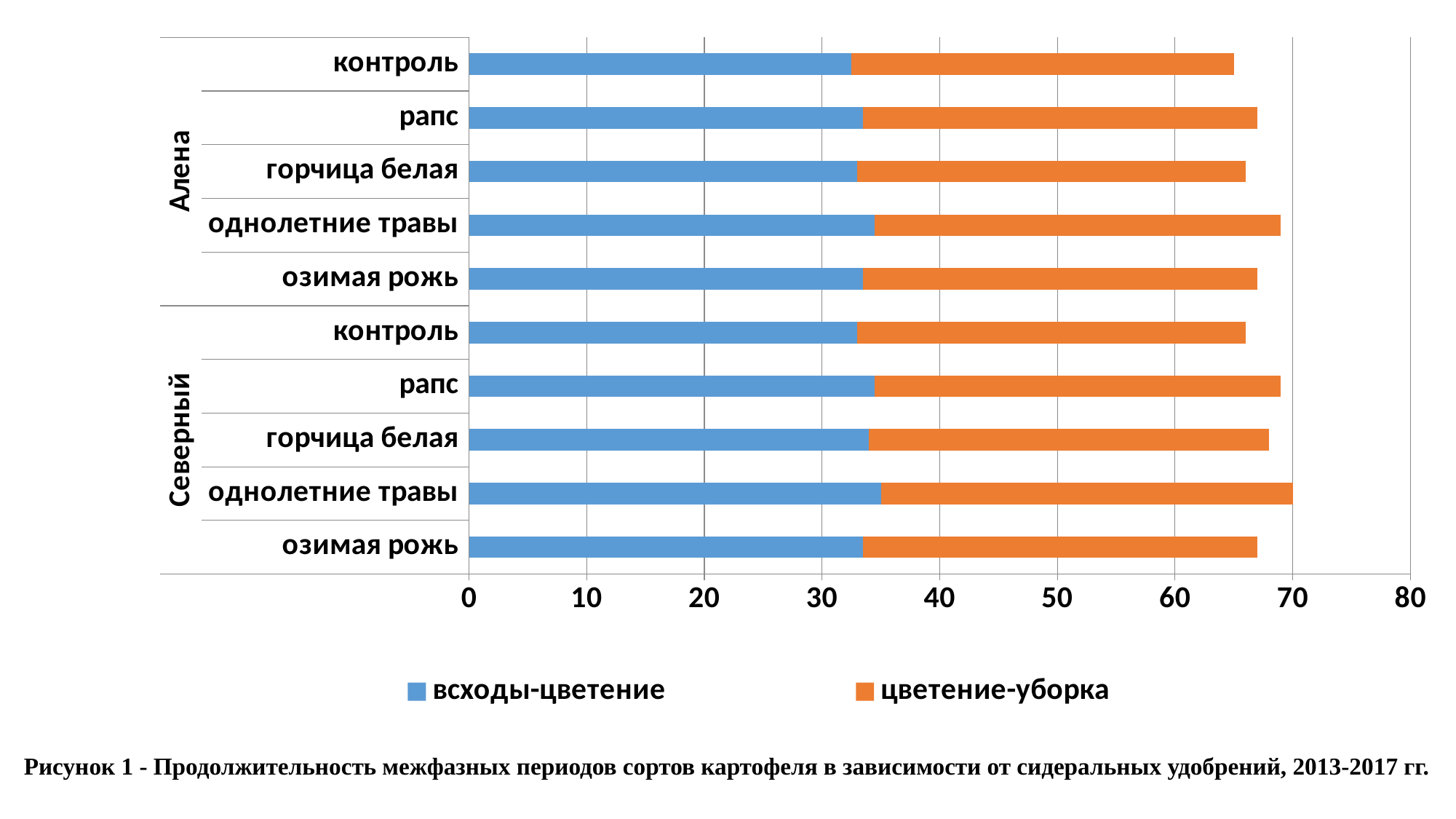
Is the total length of the bar for однолетние травы (Северный) greater or less than 60? greater Is the всходы-цветение value for контроль (Алена) greater or less than 40? less Is the всходы-цветение value for однолетние травы (Северный) greater or less than 30? greater How many categories are shown for the variety Алена? 5 What are the two variety names shown as group labels on the vertical axis? Алена and Северный How many series does the legend list? 2 How many bars are plotted in the chart in total? 10 Which series is shown in orange? цветение-уборка What kind of chart is shown on the slide? bar chart